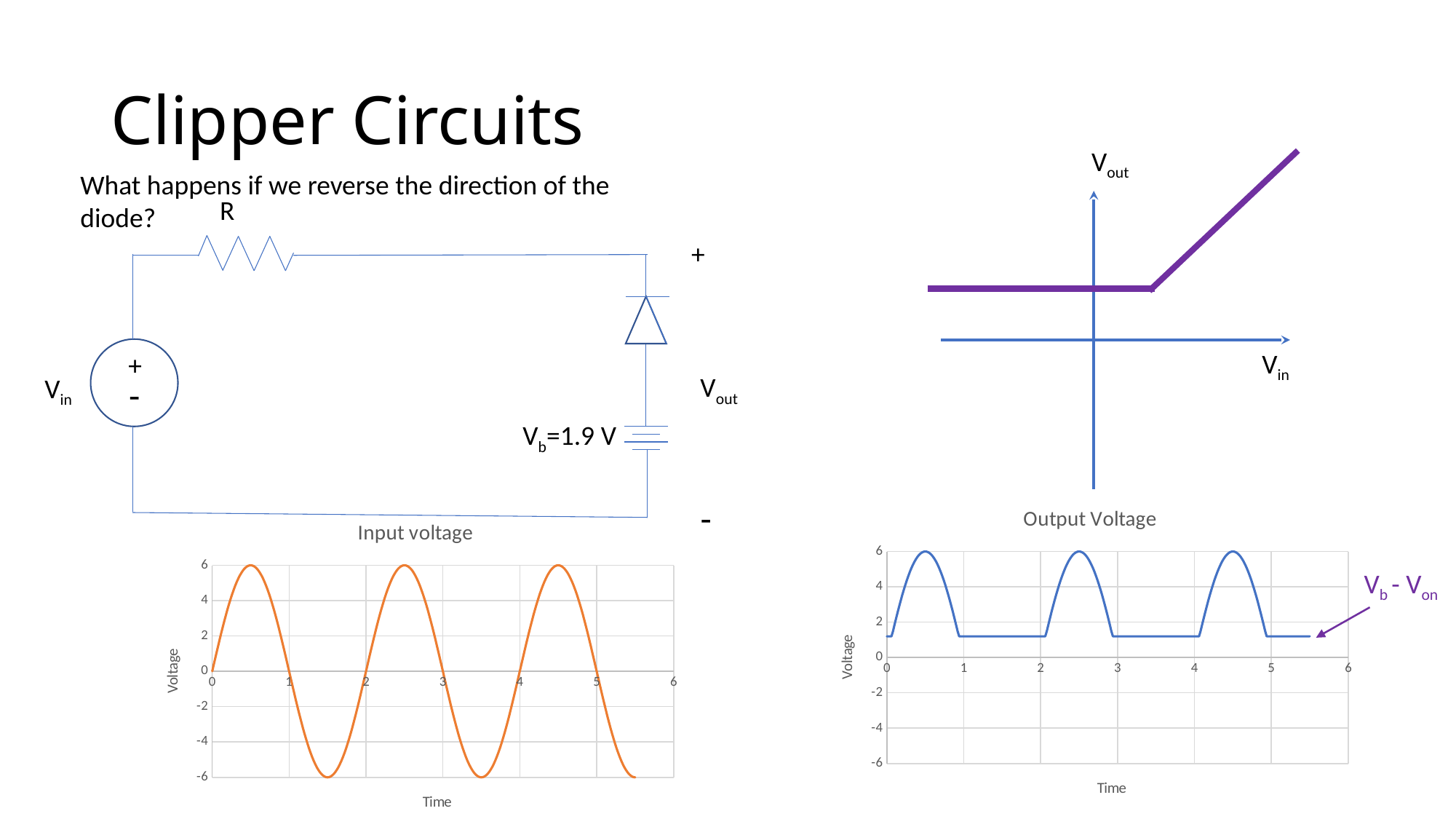
In the "Input voltage" chart, what is the lowest value reached by the waveform? -6 What kind of chart is the "Input voltage" chart? line chart In the "Input voltage" chart, what is the voltage at time 0? 0 What is the x-axis title of the "Input voltage" chart? Time In the "Output Voltage" chart, is the lowest value of the waveform greater or less than -2? greater What kind of chart is the "Output Voltage" chart? line chart How many peaks does the waveform in the "Input voltage" chart show? 3 In the "Input voltage" chart, what is the peak value reached by the waveform? 6 In the "Output Voltage" chart, is the flat clipped level of the waveform greater or less than 0? greater In the "Output Voltage" chart, what is the peak value reached by the waveform? 6 What is the title of the chart on the right side of the slide? Output Voltage In the "Output Voltage" chart, is the flat clipped level of the waveform greater or less than 2? less